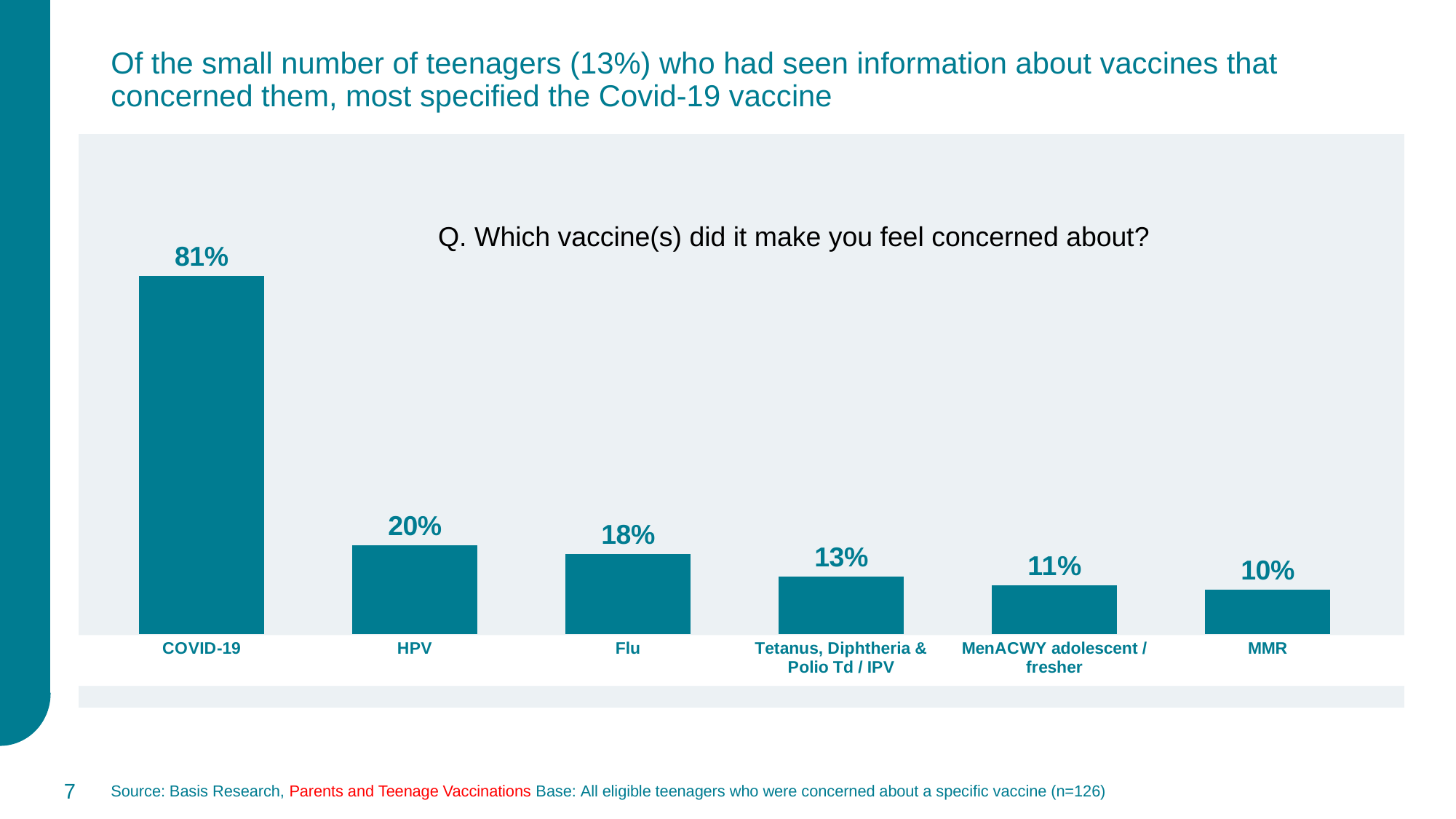
What is the difference between the values for Tetanus, Diphtheria & Polio Td / IPV and MMR? 3 percentage points How many vaccine categories are shown in the chart? 6 What is the value shown for HPV? 20% Which vaccine has the lowest value in the chart? MMR What is the value shown for Flu? 18% What question is the chart based on, as shown above the bars? Q. Which vaccine(s) did it make you feel concerned about? What is the value shown for MenACWY adolescent / fresher? 11% Which has a larger value, HPV or Flu? HPV What percentage of concerned teenagers specified the COVID-19 vaccine? 81% What is the difference between the values for COVID-19 and HPV? 61 percentage points What type of chart is shown on the slide? Bar chart Which vaccine has the highest value in the chart? COVID-19